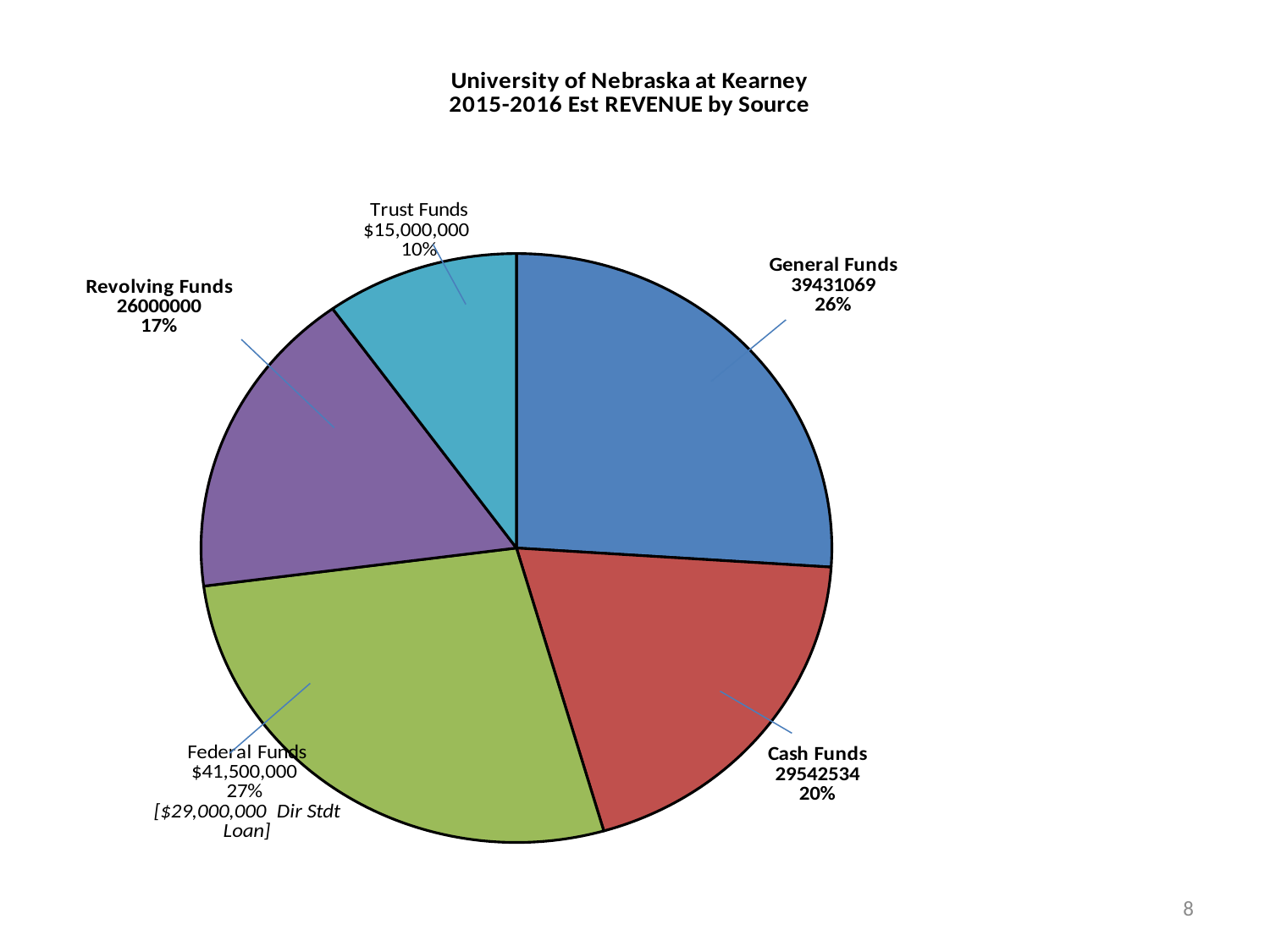
How many slices does the pie chart have? 5 What is the value shown for Federal Funds? $41,500,000 Which is larger, the share for Cash Funds or the share for Revolving Funds? Cash Funds What is the value shown for Revolving Funds? 26000000 What is the value shown for Trust Funds? $15,000,000 What is the difference in percentage points between the Revolving Funds share and the Trust Funds share? 7 percentage points Which revenue source has the smallest share of the pie? Trust Funds What kind of chart is shown on the slide? Pie chart What share of the pie does Revolving Funds represent? 17% Which revenue source has the largest share of the pie? Federal Funds What is the value shown for General Funds? 39431069 What share of the pie does Cash Funds represent? 20%